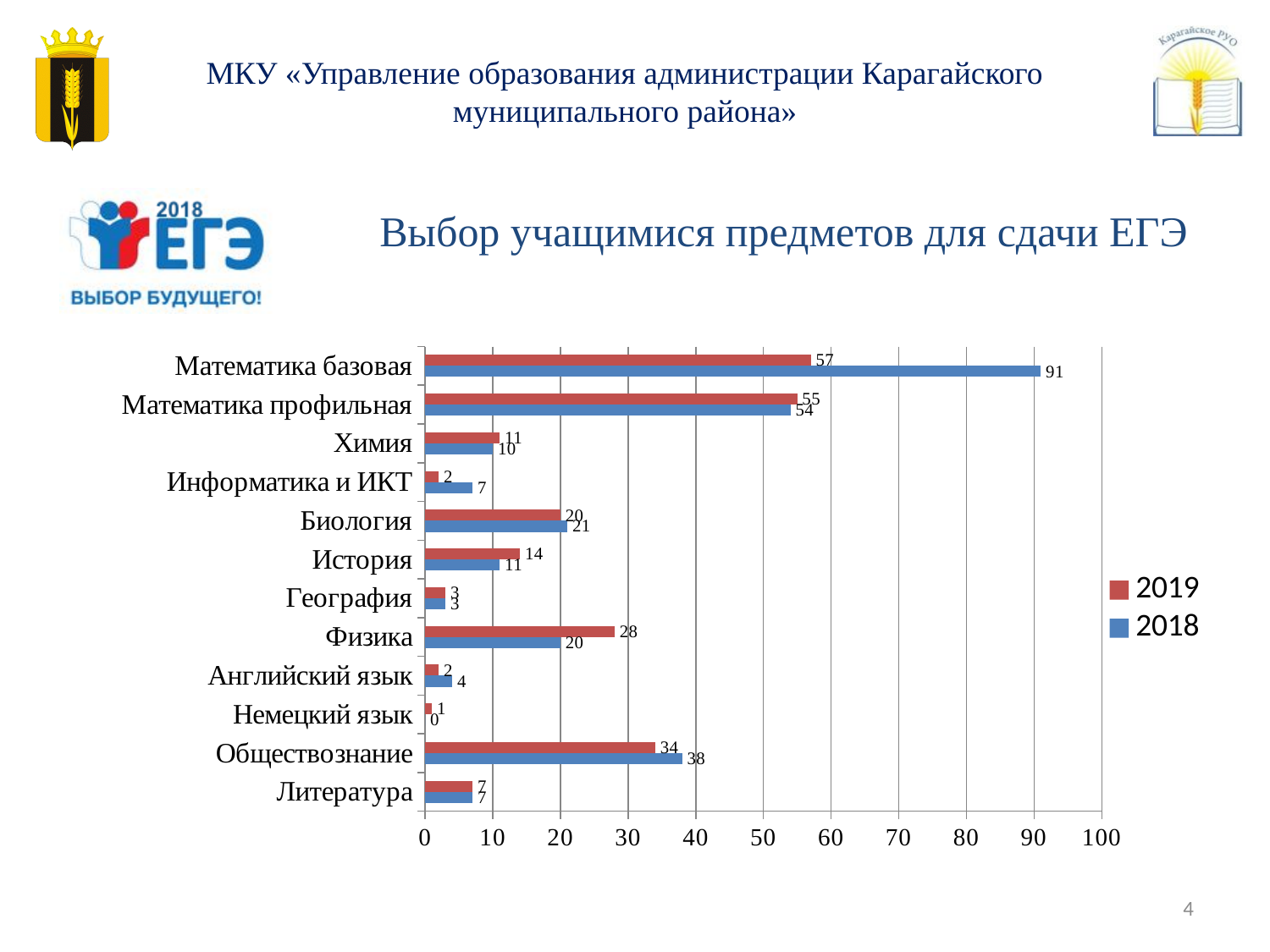
Which is larger for Физика: the 2019 value or the 2018 value? 2019 How many series does the legend list? 2 Which colour represents the 2019 series in the legend? red What kind of chart is shown on the slide? bar chart What is the value for Физика in 2019? 28 Which subject has the highest value in the 2018 series? Математика базовая Which subject has the lowest value in the 2018 series? Немецкий язык What is the value for Обществознание in 2018? 38 What is the difference between the 2018 and 2019 values for Математика базовая? 34 How many subjects are shown on the chart? 12 What is the value for Математика базовая in 2018? 91 Is the value for Математика базовая in 2018 greater or less than 80? greater